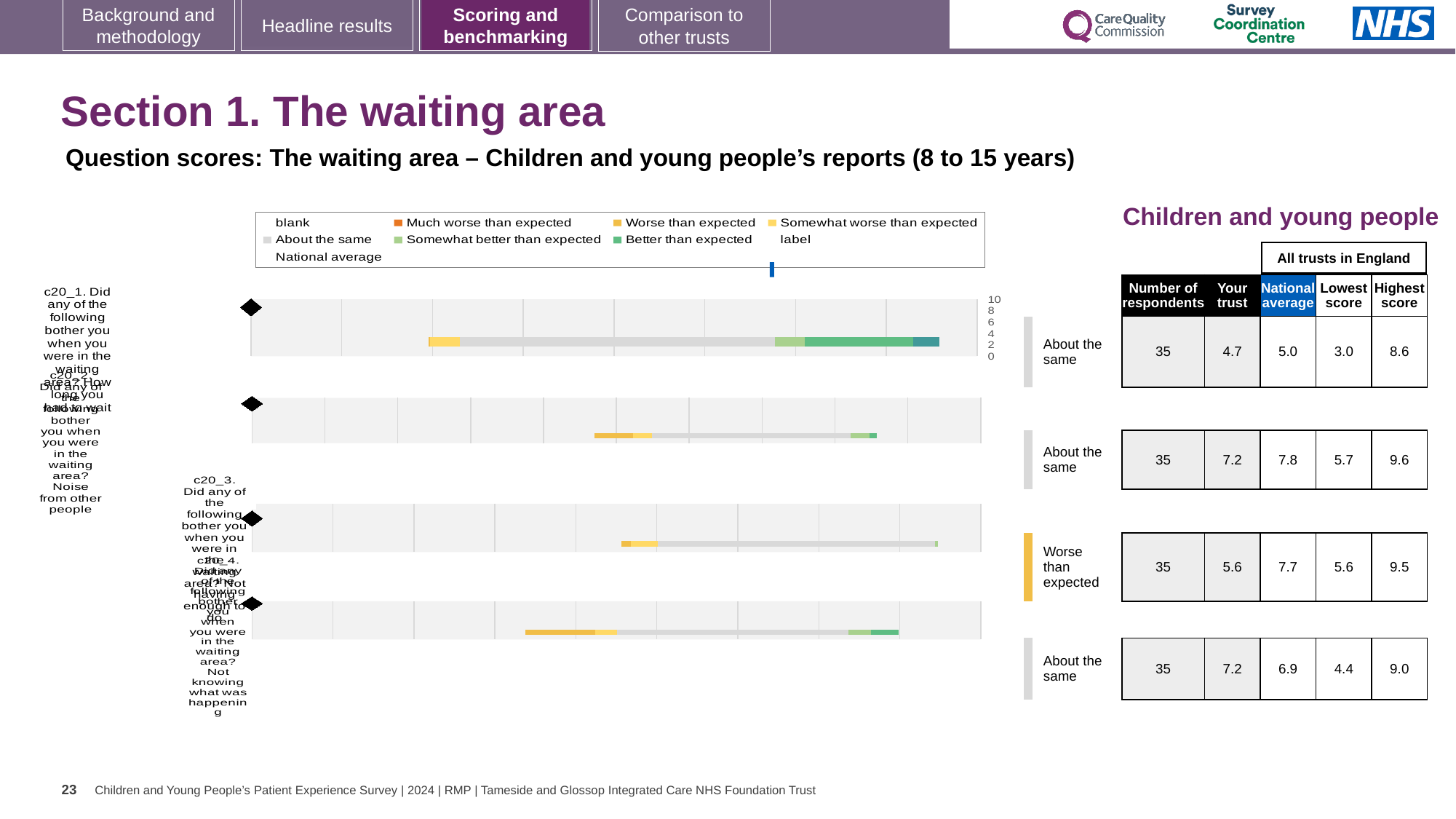
How many of the four charts are labelled 'About the same'? 3 In the table next to the charts, what is the Lowest score for the fourth question (c20_4)? 4.4 What is the difference between the Highest score and the Lowest score for the first question (c20_1) in the table? 5.6 How many entries does the chart legend list? 9 What kind of chart is used to show the question scores on this slide? bar chart In the table next to the charts, what is the 'Your trust' score for the first question (c20_1)? 4.7 In the table next to the charts, what is the National average for the third question (c20_3)? 7.7 In the table next to the charts, what is the Highest score for the second question (c20_2)? 9.6 How many separate bar charts (one per question) are shown on the slide? 4 What is the highest value shown on the axis of the first bar chart? 10 Which question has the lowest 'Your trust' score in the table next to the charts? c20_1 Which legend entry is shown in orange? Much worse than expected